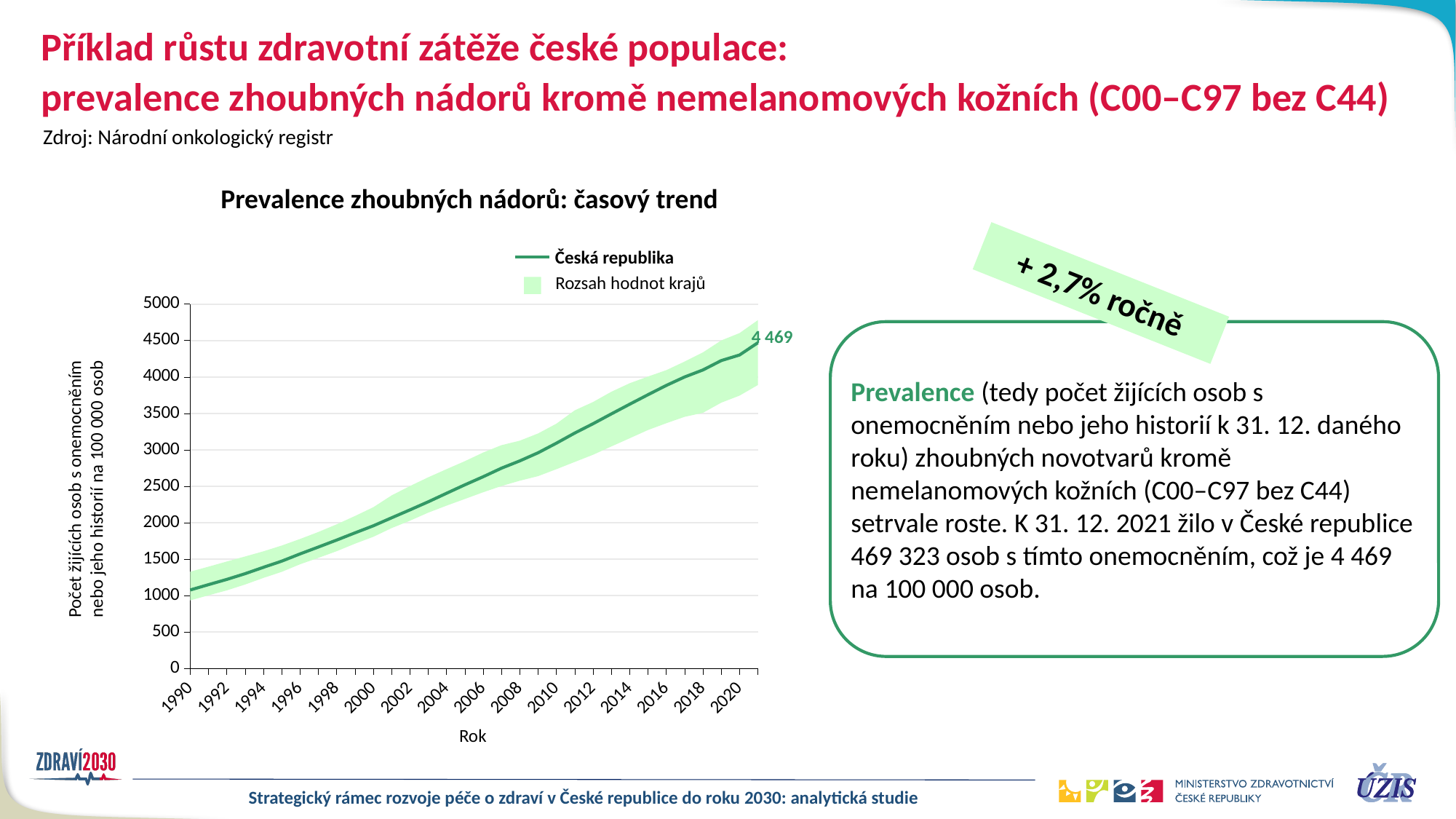
Is the value for Česká republika in 2014 greater or less than 3500? greater Does the Česká republika line rise or fall over the years shown on the x axis? rises What is the value printed as a data label at the end of the Česká republika line? 4 469 Is the value for Česká republika in 1990 greater or less than 1500? less Is the value for Česká republika in 2012 greater or less than 3000? greater What is the title of the chart? Prevalence zhoubných nádorů: časový trend What does the shaded green band in the chart represent, according to the legend? Rozsah hodnot krajů Which year has the larger value for Česká republika, 1990 or 2020? 2020 How many entries does the chart legend list? 2 What kind of chart is shown on the slide? line chart How many year labels are shown on the x axis of the chart? 16